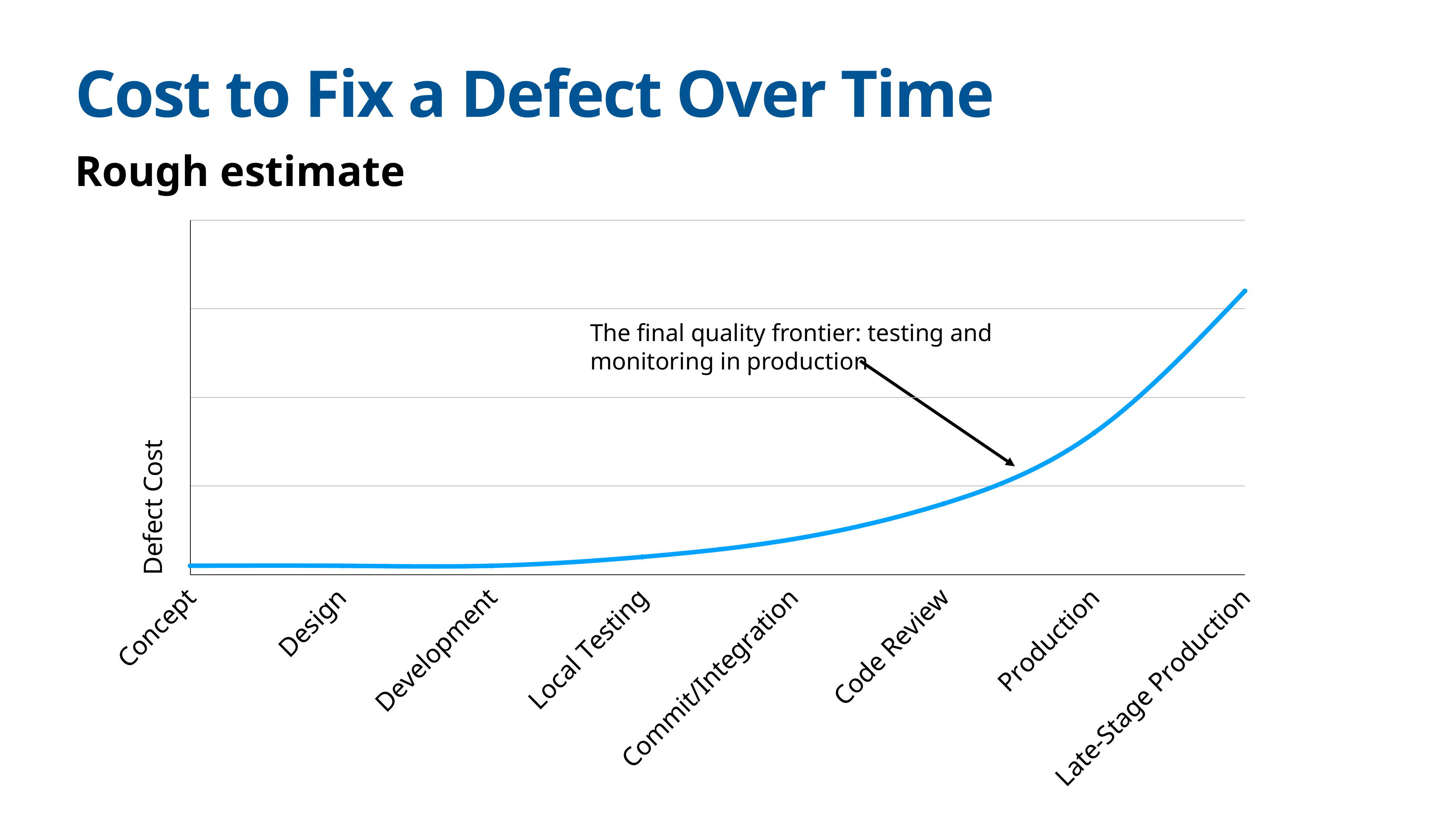
Which stage has the highest defect cost on the chart? Late-Stage Production What does the annotation text on the chart say? The final quality frontier: testing and monitoring in production How many stages are plotted along the x axis of the chart? 8 What is the first stage shown on the x axis of the chart? Concept What is the label on the vertical axis of the chart? Defect Cost What stage comes immediately after Code Review on the x axis? Production Does the defect cost rise or fall as the stages move from Concept to Late-Stage Production? Rise Which has a lower defect cost, Commit/Integration or Late-Stage Production? Commit/Integration Which has a higher defect cost, Production or Design? Production Which has a higher defect cost, Code Review or Local Testing? Code Review What kind of chart is shown on the slide? Line chart